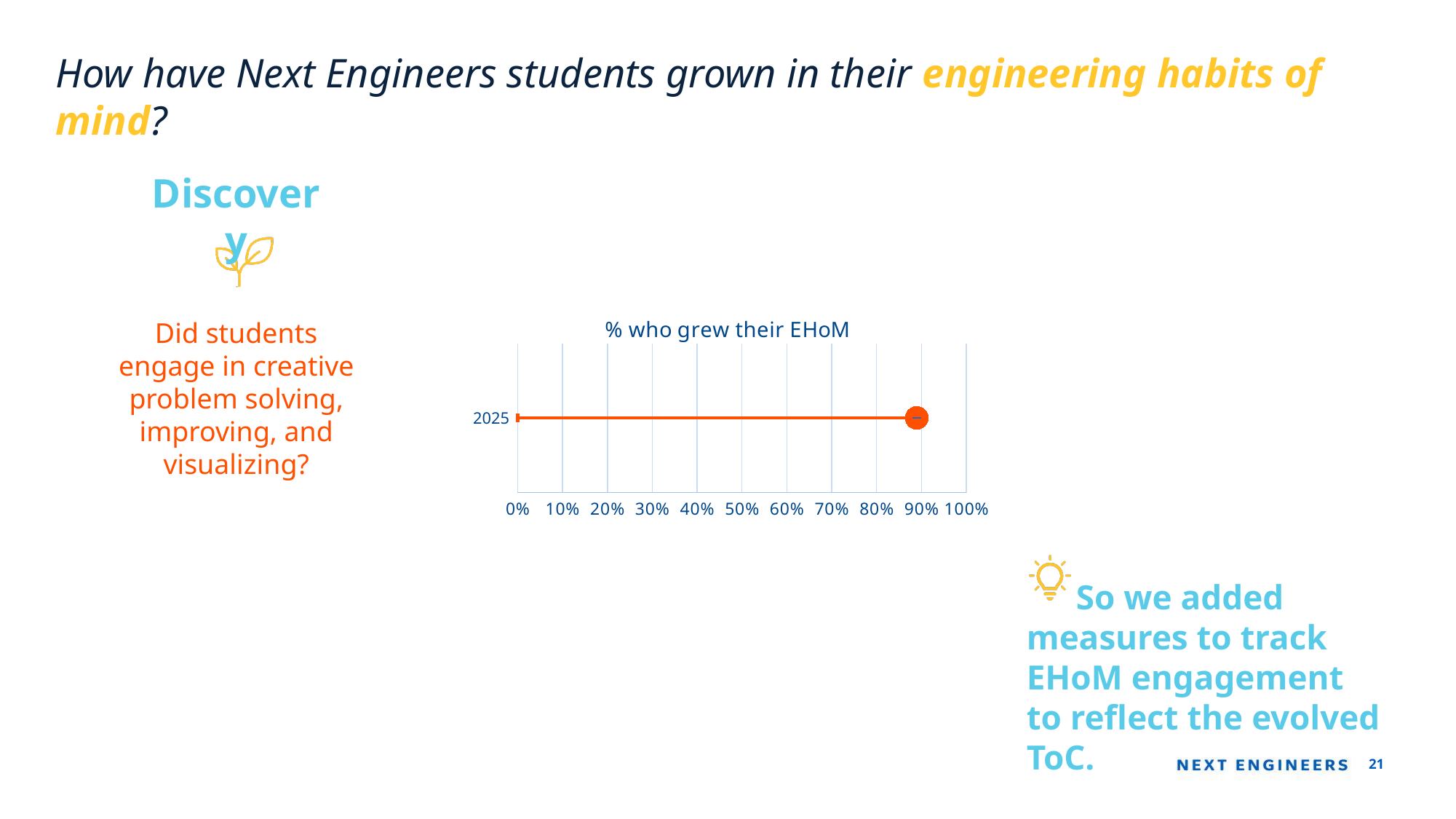
What is the title of the chart? % who grew their EHoM Is the value for 2025 greater or less than 80%? greater What is the label of the single category on the chart's vertical axis? 2025 What is the maximum value shown on the chart's horizontal axis? 100% Is the value for 2025 greater or less than 70%? greater How many categories are plotted on the chart? 1 Is the value for 2025 greater or less than 100%? less